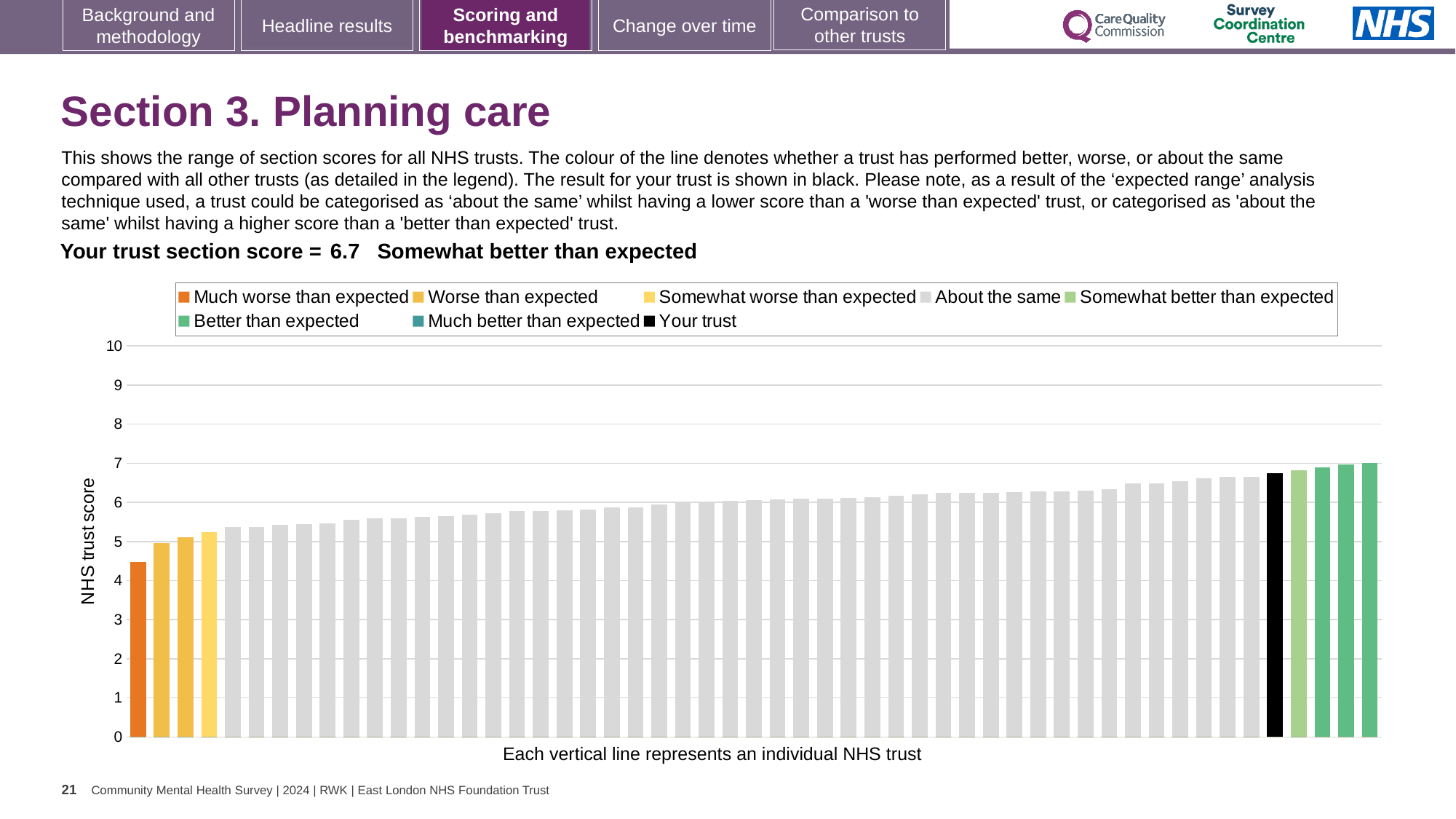
Which category does the slide say your trust falls into for this section? Somewhat better than expected What is the label on the vertical axis of the chart? NHS trust score What is the section score for your trust shown on the slide? 6.7 Is the value of the rightmost bar greater or less than 6? greater Is the value of the leftmost (orange) bar greater or less than 5? less How many bars are coloured in the 'Better than expected' green shade? 3 Do the bar values rise or fall from left to right along the x axis? rise How many bars are coloured orange (Much worse than expected)? 1 Which colour is used for the 'Your trust' bar? black How many entries does the chart legend list? 8 What kind of chart is shown on the slide? bar chart Is the value of the black 'Your trust' bar greater or less than 6? greater